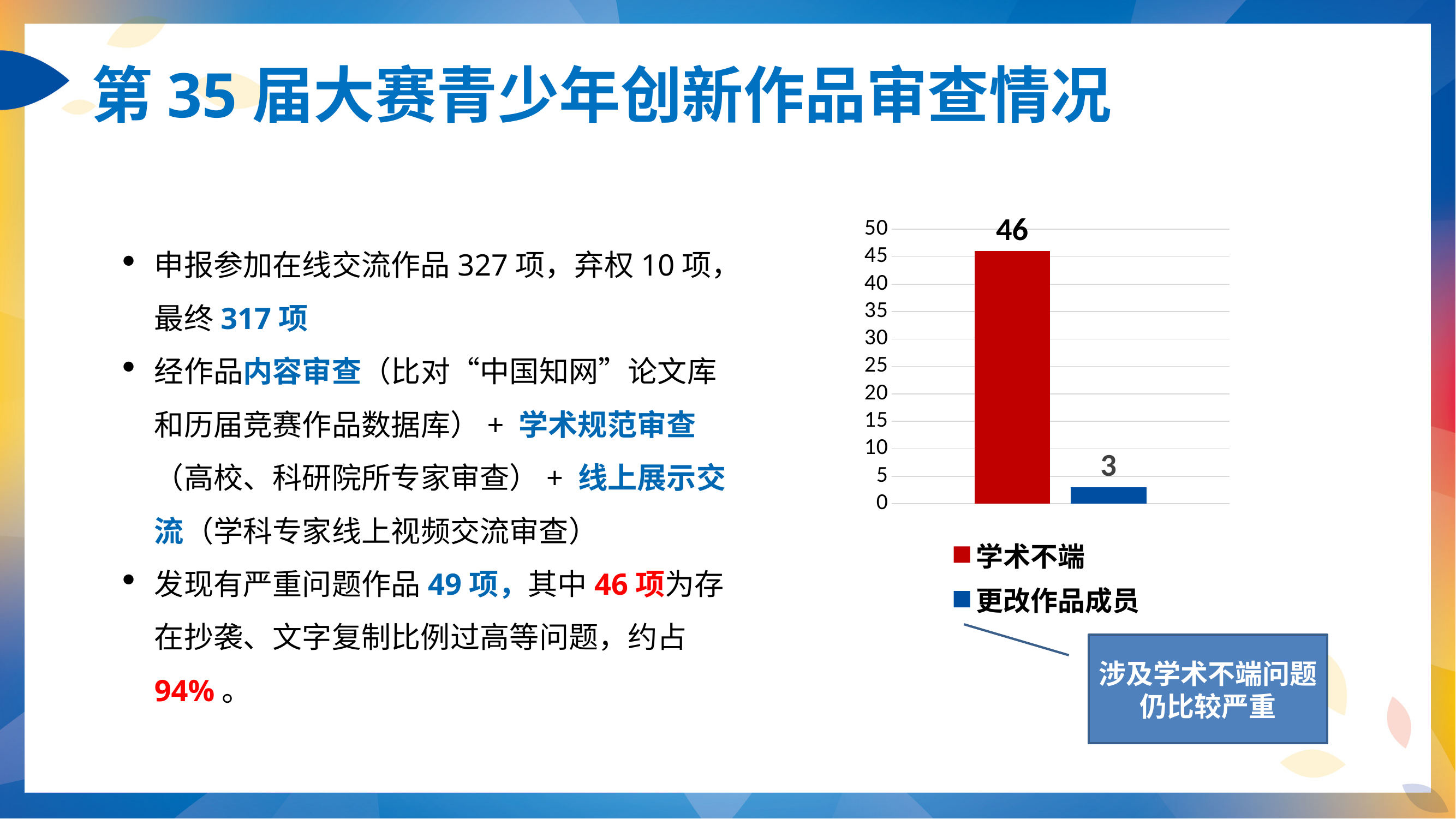
Is the value for 更改作品成员 greater or less than 5? less What colour is the bar for 学术不端? red What is the difference between the values for 学术不端 and 更改作品成员? 43 Which is larger, the value for 学术不端 or the value for 更改作品成员? 学术不端 Which series has the lowest value in the chart? 更改作品成员 What kind of chart is shown on the slide? bar chart Which series has the highest value in the chart? 学术不端 How many series does the legend list? 2 How many bars are plotted in the chart? 2 Is the value for 学术不端 greater or less than 40? greater What is the value for 学术不端 in the chart? 46 What is the value for 更改作品成员 in the chart? 3